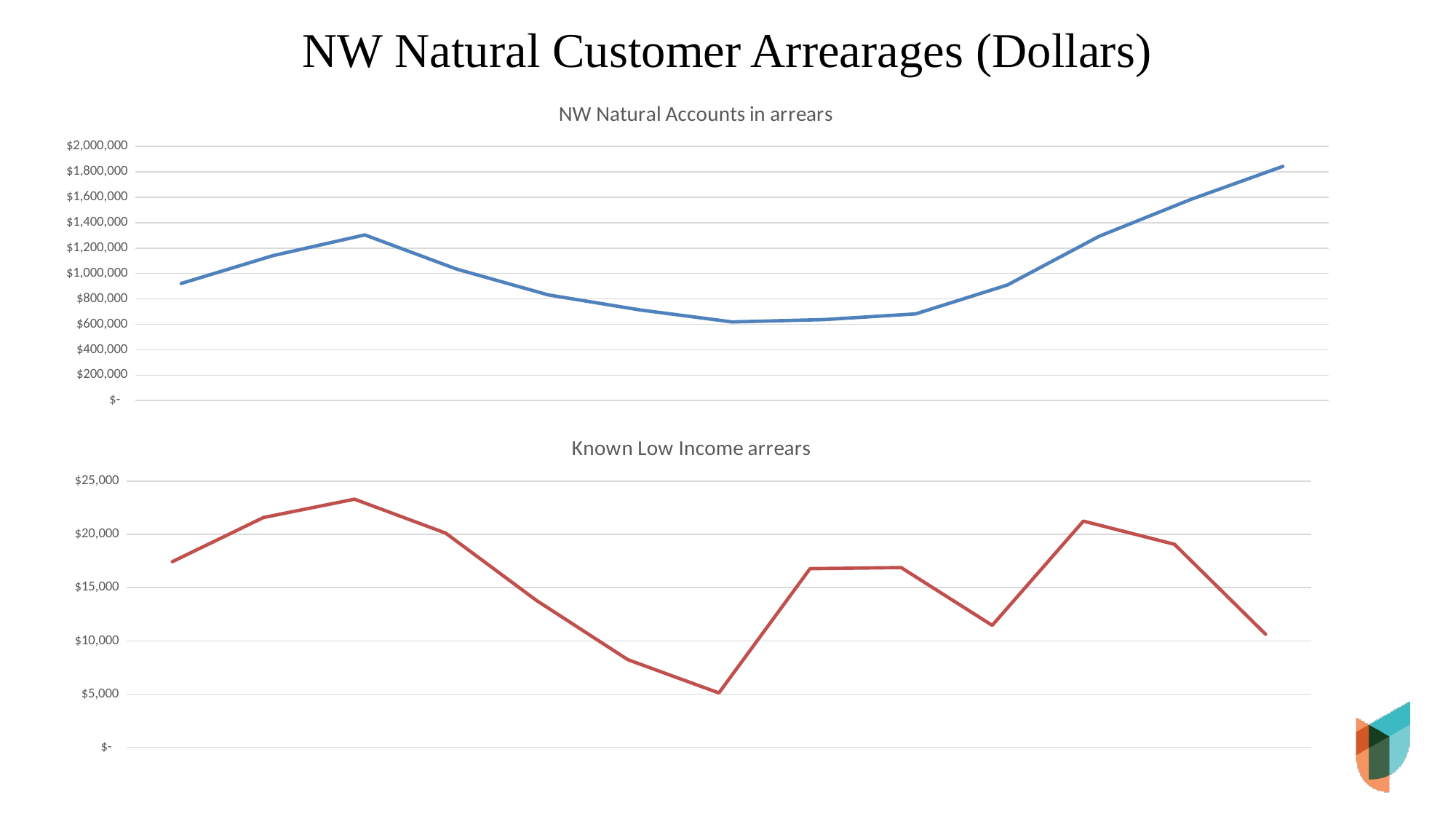
On the top chart, "NW Natural Accounts in arrears", does the line end higher or lower than it starts? higher On the bottom chart, "Known Low Income arrears", does the line end higher or lower than it starts? lower How many data points are plotted on the bottom chart, "Known Low Income arrears"? 13 On the top chart, "NW Natural Accounts in arrears", is the first (leftmost) value greater or less than $1,000,000? less What type of chart is the top chart titled "NW Natural Accounts in arrears"? line chart What type of chart is the bottom chart titled "Known Low Income arrears"? line chart On the bottom chart, "Known Low Income arrears", is the highest point of the line greater or less than $20,000? greater What colour is the line on the bottom chart, "Known Low Income arrears"? red On the top chart, "NW Natural Accounts in arrears", is the lowest point of the line greater or less than $800,000? less How many data points are plotted on the top chart, "NW Natural Accounts in arrears"? 13